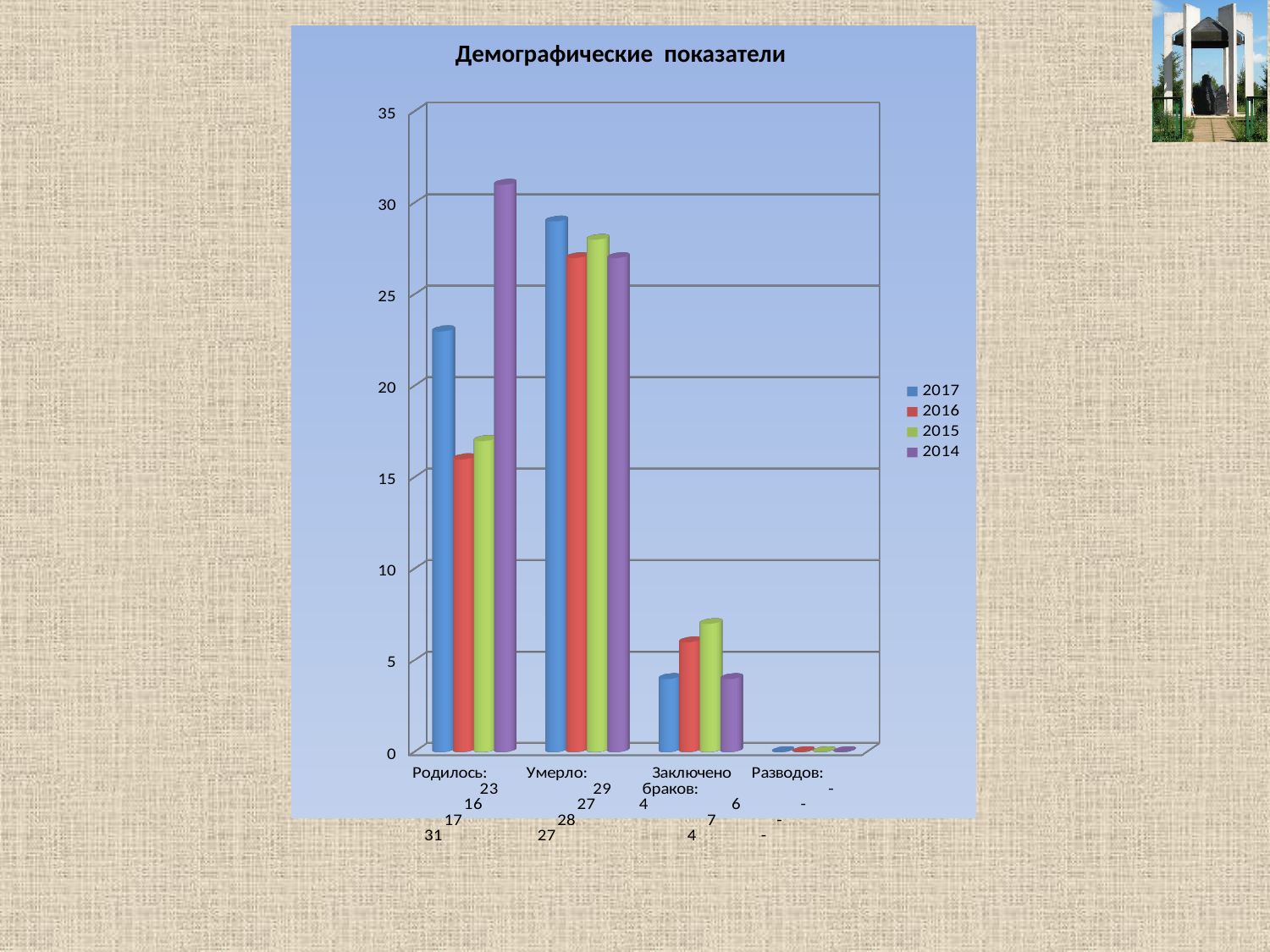
Which year has the lowest value in the Родилось category? 2016 Is the value for 2017 in the Родилось category greater or less than 20? greater How many series does the legend list? 4 How many categories are shown on the x axis? 4 What type of chart is shown on the slide? bar chart What is the difference between the 2014 and 2017 values in the Родилось category? 8 What is the title of the chart? Демографические показатели What is the value for 2015 in the Заключено браков category? 7 What is the value for 2014 in the Родилось category? 31 Which year has the highest value in the Родилось category? 2014 What is the value for 2017 in the Умерло category? 29 Which is larger in the Умерло category: the value for 2017 or the value for 2016? 2017